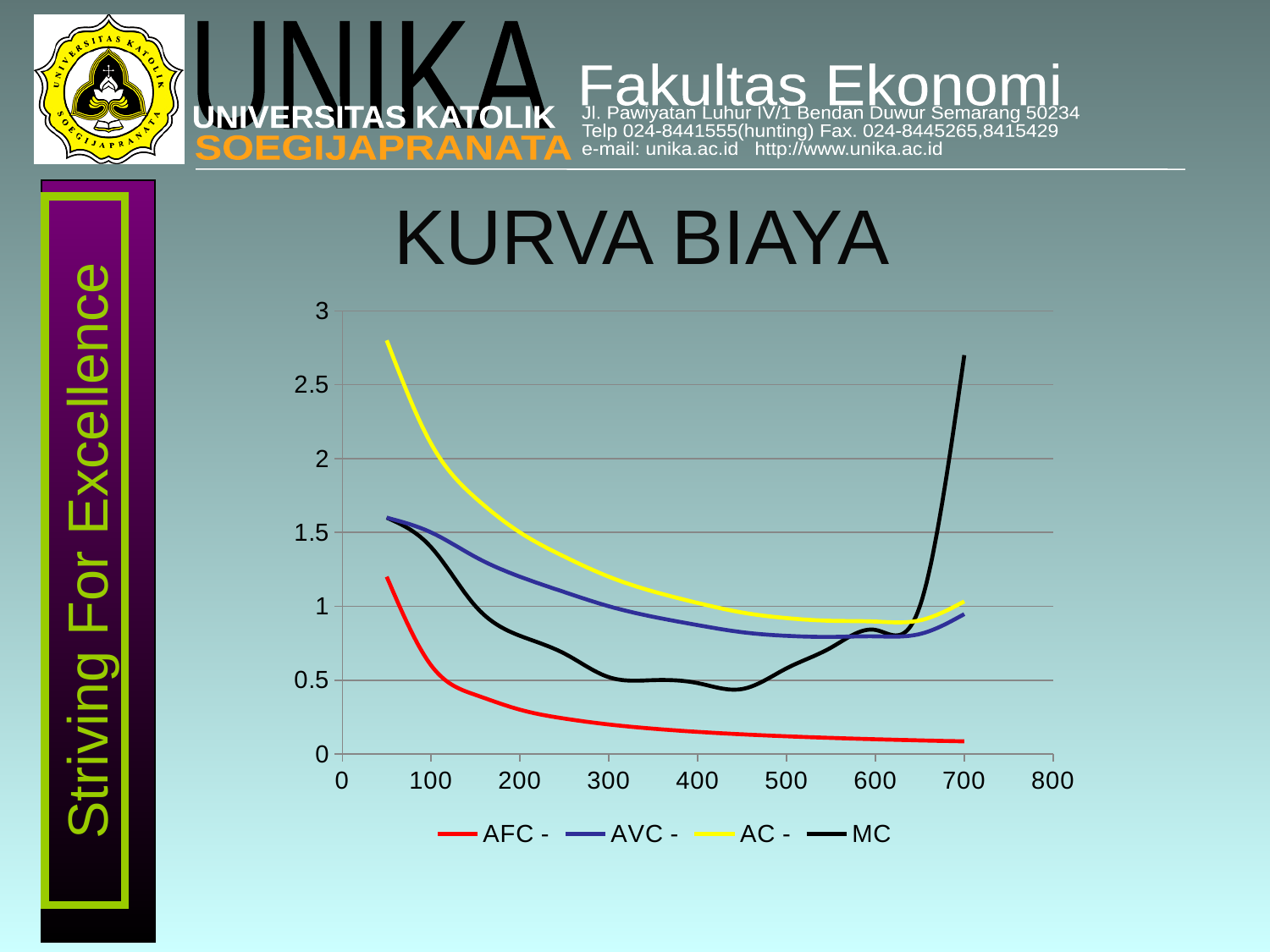
Does the AFC line rise or fall as x increases? fall Is the value of MC at x = 700 greater or less than 2.5? greater Is the value of AC at x = 50 greater or less than 2.5? greater What kind of chart is shown on the slide? line chart Is the value of AVC at x = 500 greater or less than 1? less What is the title of the chart? KURVA BIAYA Which colour is used for the MC line? black How many series does the legend list? 4 Which series has the lowest value at x = 100? AFC Which series has the highest value at x = 100? AC